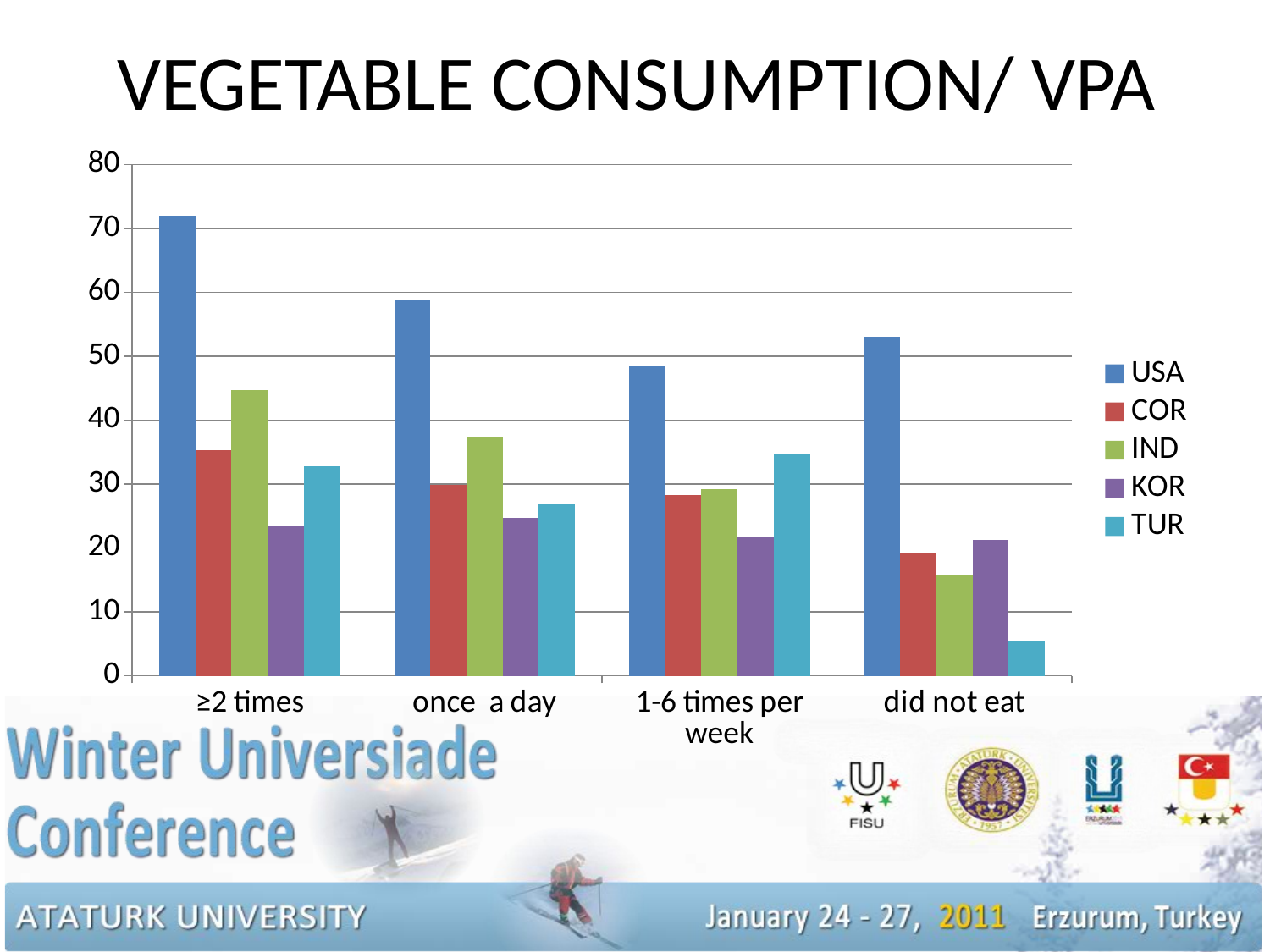
In the "1-6 times per week" category, which is larger, TUR or KOR? TUR How many series does the legend list? 5 Which series has the lowest value in the "did not eat" category? TUR Is the value for USA in the "≥2 times" category greater or less than 60? greater Is the value for TUR in the "did not eat" category greater or less than 10? less How many categories are shown on the x axis? 4 What kind of chart is shown on the slide? bar chart Which series has the highest value in the "did not eat" category? USA What is the title of the chart? VEGETABLE CONSUMPTION/ VPA Which series has the highest value in the "≥2 times" category? USA Which series has the lowest value in the "≥2 times" category? KOR In the "≥2 times" category, which is larger, IND or COR? IND